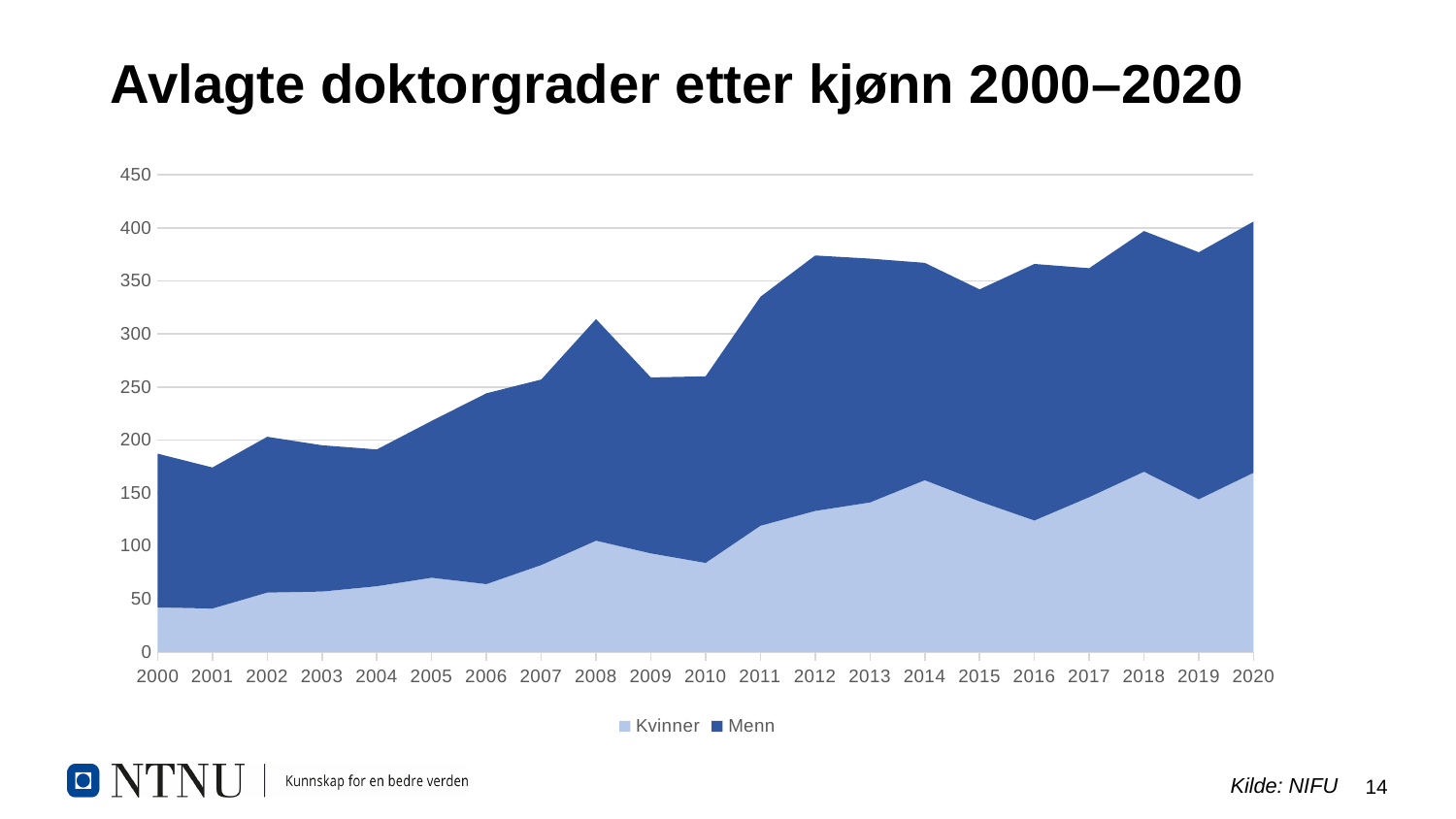
Does the total number of doctorates generally rise or fall from 2000 to 2020? rise How many years are shown along the x axis? 21 Is the total number of doctorates (Kvinner plus Menn) in 2020 greater or less than 400? greater What kind of chart is shown on the slide? Stacked area chart Is the total number of doctorates (Kvinner plus Menn) in 2000 greater or less than 200? less What is the title of the chart? Avlagte doktorgrader etter kjønn 2000–2020 How many series does the legend list? 2 Is the value for Kvinner in 2020 greater or less than 150? greater Which year has the larger total number of doctorates, 2008 or 2009? 2008 Which series are listed in the legend? Kvinner and Menn In which year is the total number of doctorates (top of the stacked area) highest? 2020